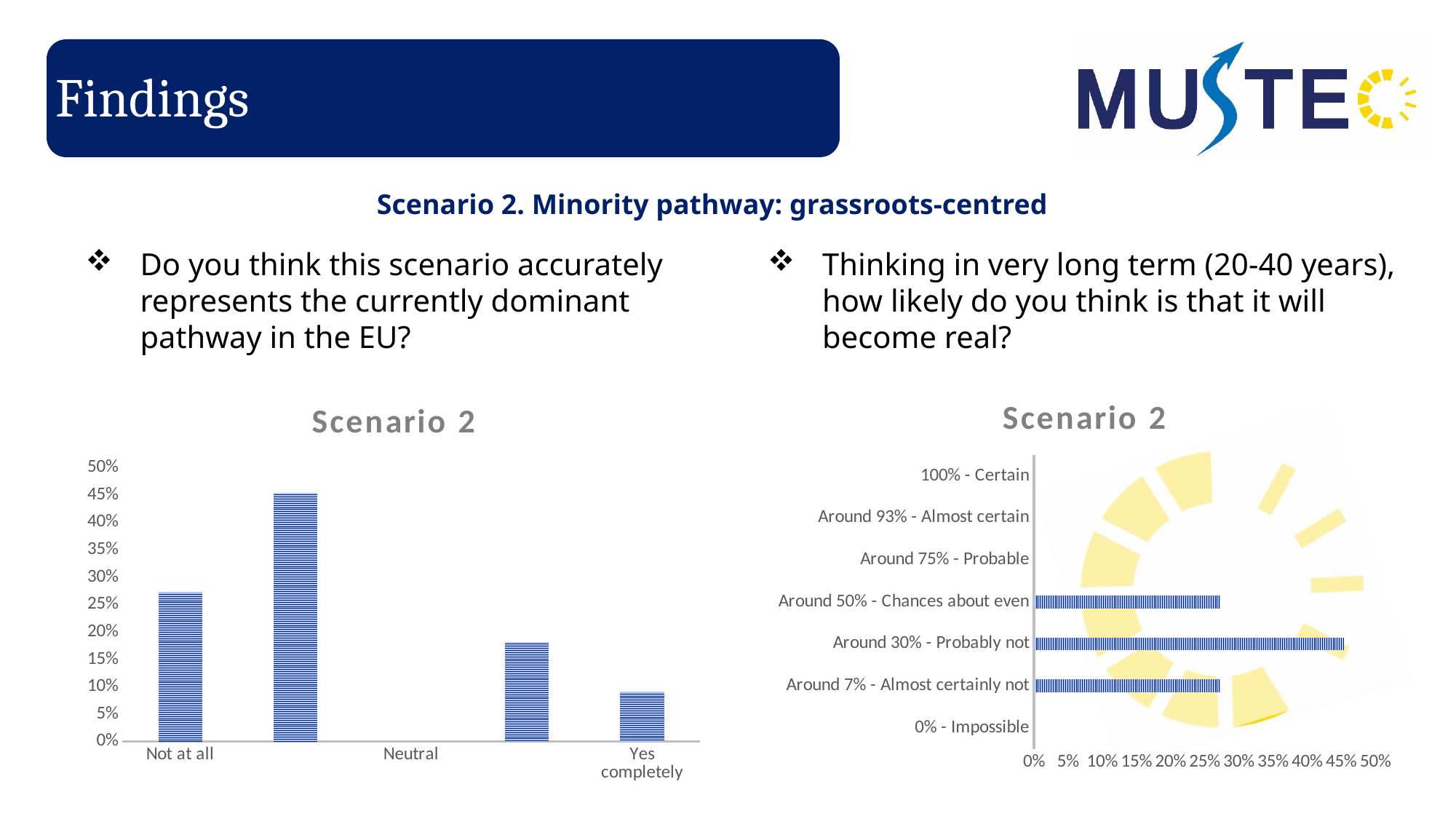
In the left chart, what is the highest value shown on the vertical axis? 50% What is the title of the left chart? Scenario 2 In the left chart, is the value for 'Yes completely' greater or less than 15%? less In the left chart, is the value for 'Not at all' greater or less than 20%? greater In the right chart, is the value for 'Around 50% - Chances about even' greater or less than 30%? less In the right chart, how many categories have a visible bar? 3 What kind of chart is the left chart on the slide? bar chart In the right chart, how many categories are listed on the vertical axis? 7 In the right chart, which category has the highest value? Around 30% - Probably not In the left chart, which is larger, the value for 'Not at all' or the value for 'Yes completely'? Not at all What kind of chart is the right chart on the slide? bar chart